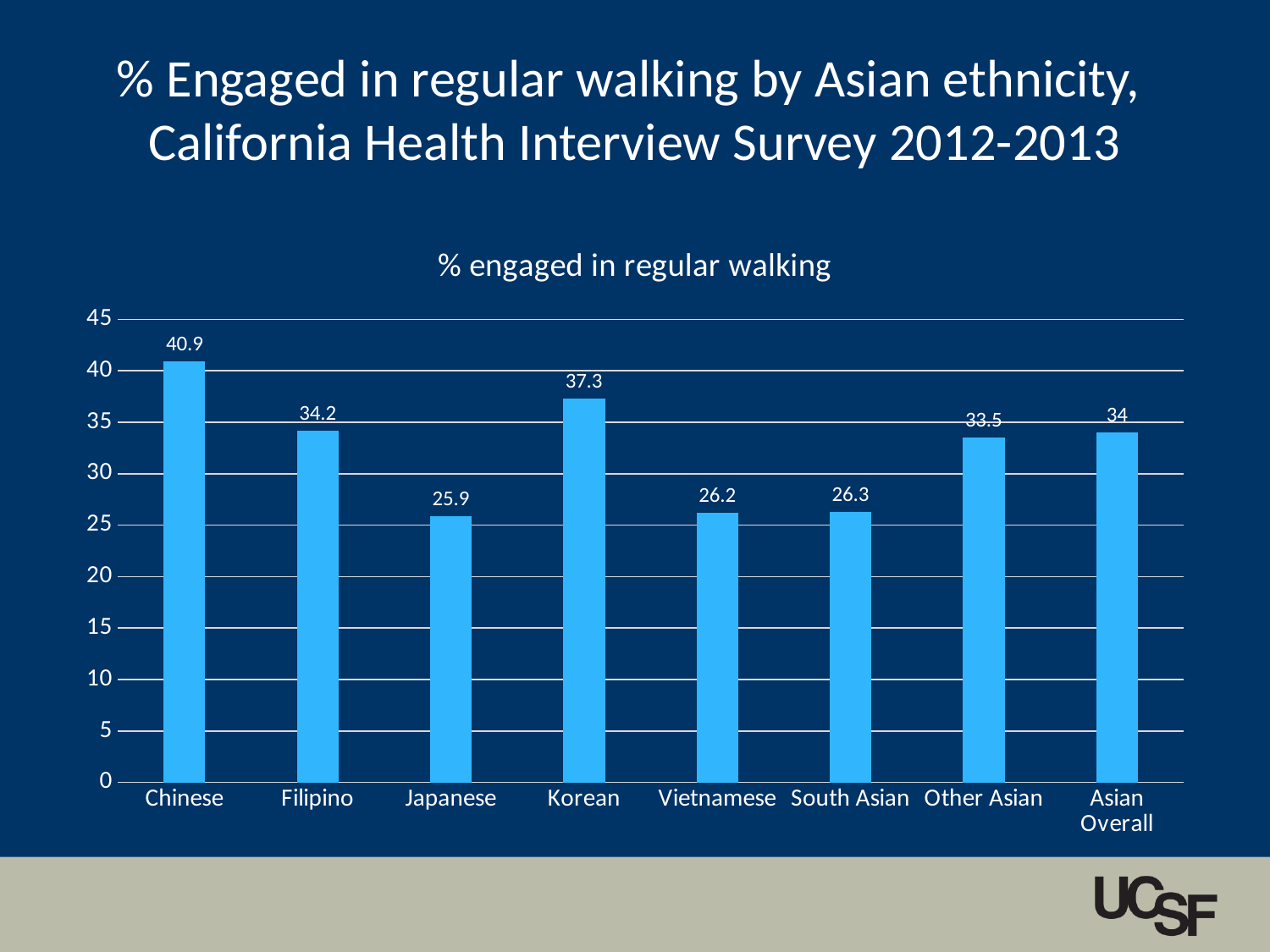
How many ethnicity categories are shown on the x axis? 8 What kind of chart is shown on the slide? bar chart What is the difference between the values for Korean and Filipino? 3.1 What is the title of the chart? % engaged in regular walking Which ethnicity has the highest % engaged in regular walking? Chinese What is the value for Asian Overall? 34 What is the difference between the values for Chinese and Japanese? 15 What is the value for Korean? 37.3 Which ethnicity has the lowest % engaged in regular walking? Japanese Which is larger, the value for Filipino or the value for Other Asian? Filipino Is the value for Vietnamese greater or less than 30? less What is the value for Chinese? 40.9